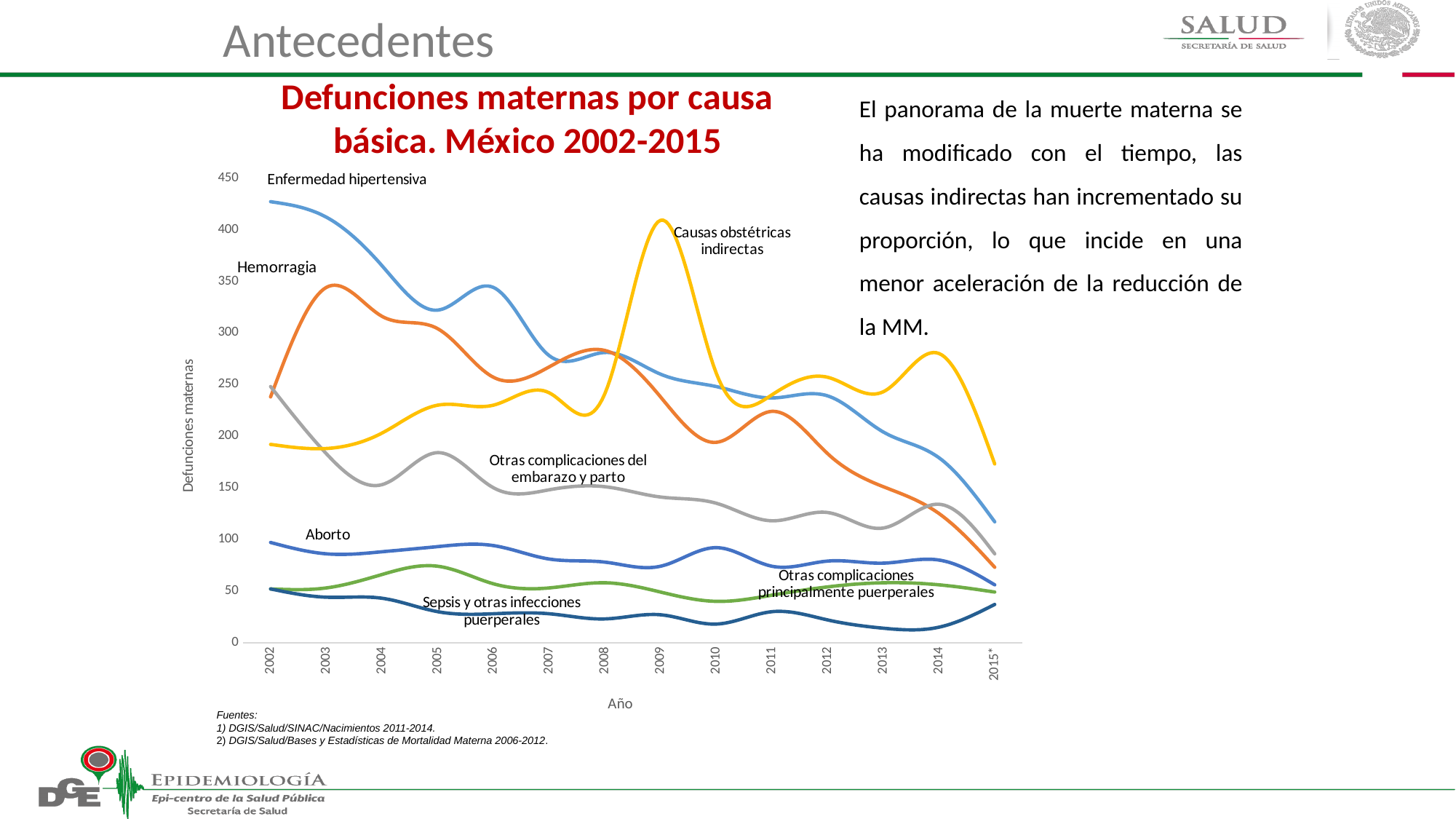
Is the value for Enfermedad hipertensiva in 2002 greater or less than 400? greater How many causes (series) are plotted in the chart? 7 Is the value for Causas obstétricas indirectas in 2009 greater or less than 350? greater Which cause has the lowest value in 2010? Sepsis y otras infecciones puerperales What is the label of the vertical axis of the chart? Defunciones maternas In 2015*, which is larger: Causas obstétricas indirectas or Enfermedad hipertensiva? Causas obstétricas indirectas Does the Enfermedad hipertensiva line rise or fall overall from 2002 to 2015*? fall Which cause has the highest value in 2002? Enfermedad hipertensiva How many years are shown along the x axis of the chart? 14 What kind of chart is shown on the slide? line chart What is the title of the chart? Defunciones maternas por causa básica. México 2002-2015 Which cause has the highest value in 2009? Causas obstétricas indirectas